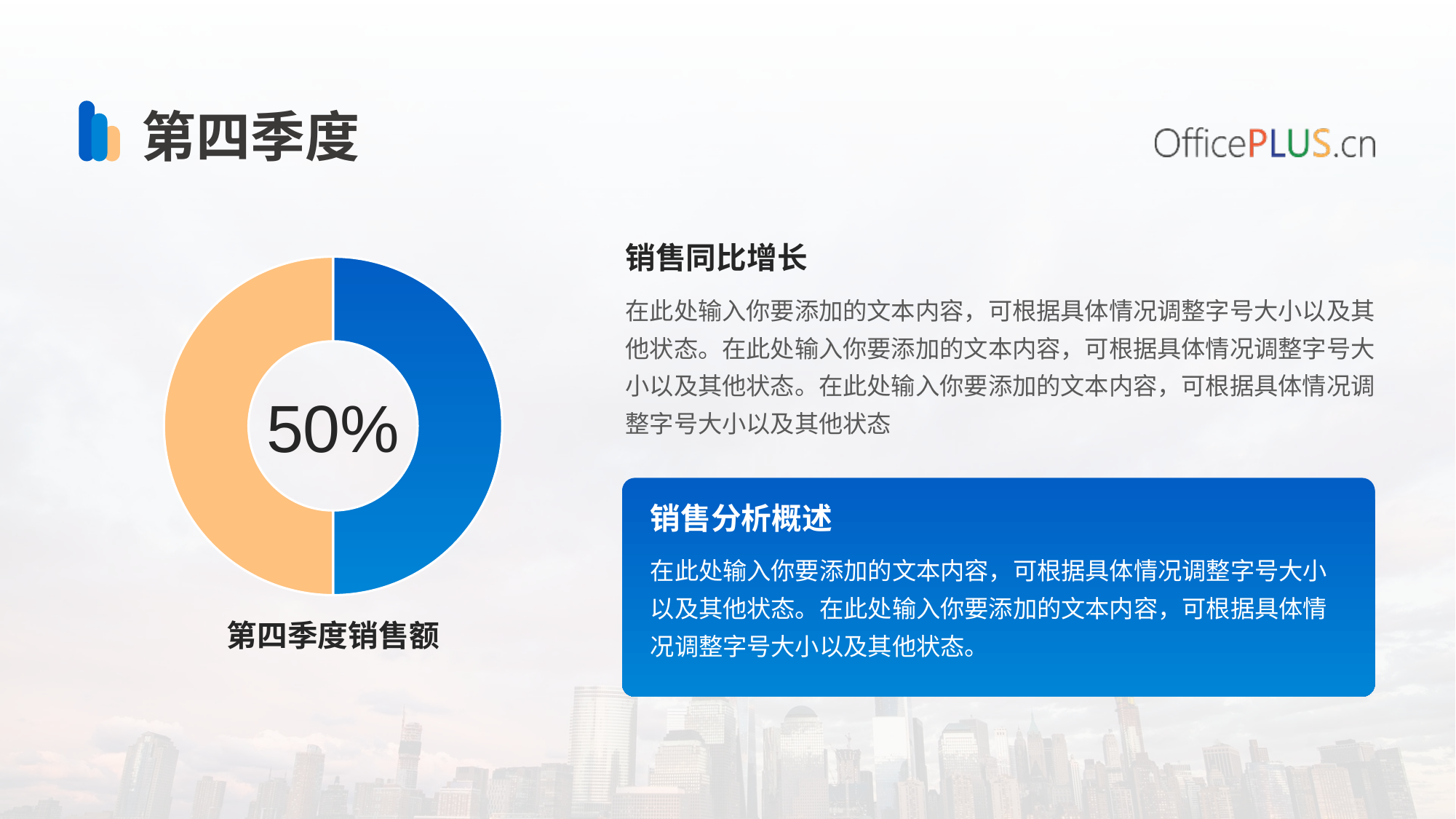
What share of the donut chart does the blue slice represent? 50% What kind of chart is shown on the slide? Donut (pie) chart What two colours are used for the slices of the donut chart? Blue and orange How many slices does the donut chart have? 2 What is the caption printed below the donut chart? 第四季度销售额 What percentage is printed in the centre of the donut chart? 50% What share of the donut chart does the orange slice represent? 50%